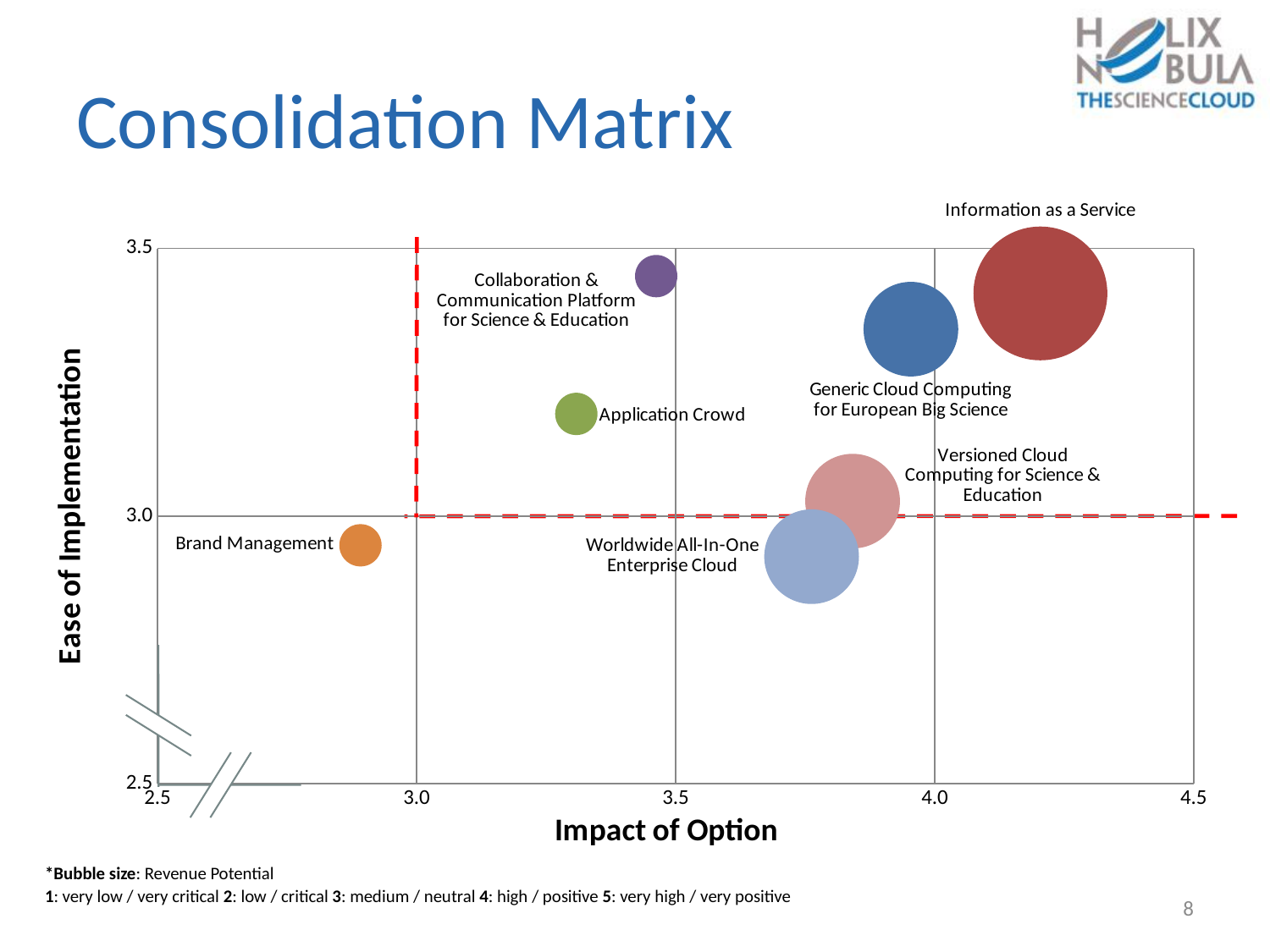
Is the Impact of Option value for Brand Management greater or less than 3.0? less Which option has the largest bubble in the Consolidation Matrix? Information as a Service Which option has the highest Impact of Option value? Information as a Service Is the Impact of Option value for Application Crowd greater or less than 3.5? less What is the title of the horizontal axis of the chart? Impact of Option Which has the higher Ease of Implementation: Application Crowd or Collaboration & Communication Platform for Science & Education? Collaboration & Communication Platform for Science & Education What kind of chart is shown on the slide? Bubble chart Which option has the lowest Impact of Option value? Brand Management What does the bubble size represent in the Consolidation Matrix? Revenue Potential Is the Ease of Implementation value for Application Crowd greater or less than 3.0? greater How many bubbles (options) are plotted in the Consolidation Matrix? 7